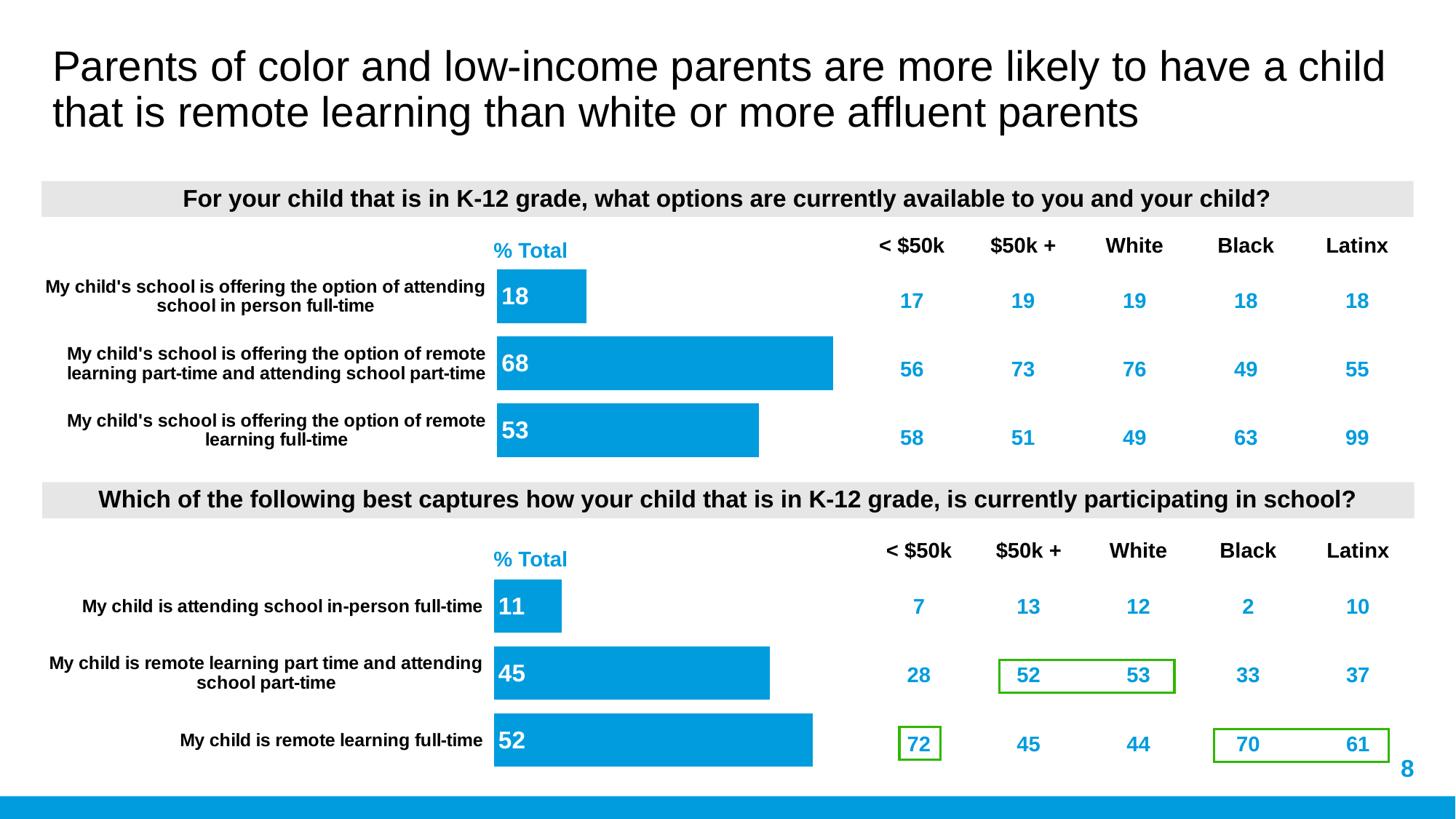
In the top chart ("what options are currently available to you and your child?"), which option has the highest % Total? My child's school is offering the option of remote learning part-time and attending school part-time In the top chart ("what options are currently available to you and your child?"), what is the % Total for "My child's school is offering the option of remote learning part-time and attending school part-time"? 68 In the bottom chart ("how your child that is in K-12 grade, is currently participating in school?"), what is the difference in % Total between "My child is remote learning full-time" and "My child is attending school in-person full-time"? 41 In the top chart ("what options are currently available to you and your child?"), what is the % Total for "My child's school is offering the option of attending school in person full-time"? 18 What is the label shown above the bars in both charts? % Total What kind of chart is the bottom chart ("how your child that is in K-12 grade, is currently participating in school?")? Bar chart In the top chart ("what options are currently available to you and your child?"), which is larger: the % Total for attending school in person full-time or for remote learning full-time? My child's school is offering the option of remote learning full-time In the bottom chart ("how your child that is in K-12 grade, is currently participating in school?"), which category has the lowest % Total? My child is attending school in-person full-time In the bottom chart ("how your child that is in K-12 grade, is currently participating in school?"), which is larger: the % Total for remote learning full-time or for remote learning part time and attending school part-time? My child is remote learning full-time How many categories (bars) does the top chart ("what options are currently available to you and your child?") show? 3 In the top chart ("what options are currently available to you and your child?"), what is the difference in % Total between the remote learning part-time option and the remote learning full-time option? 15 In the bottom chart ("how your child that is in K-12 grade, is currently participating in school?"), what is the % Total for "My child is remote learning full-time"? 52